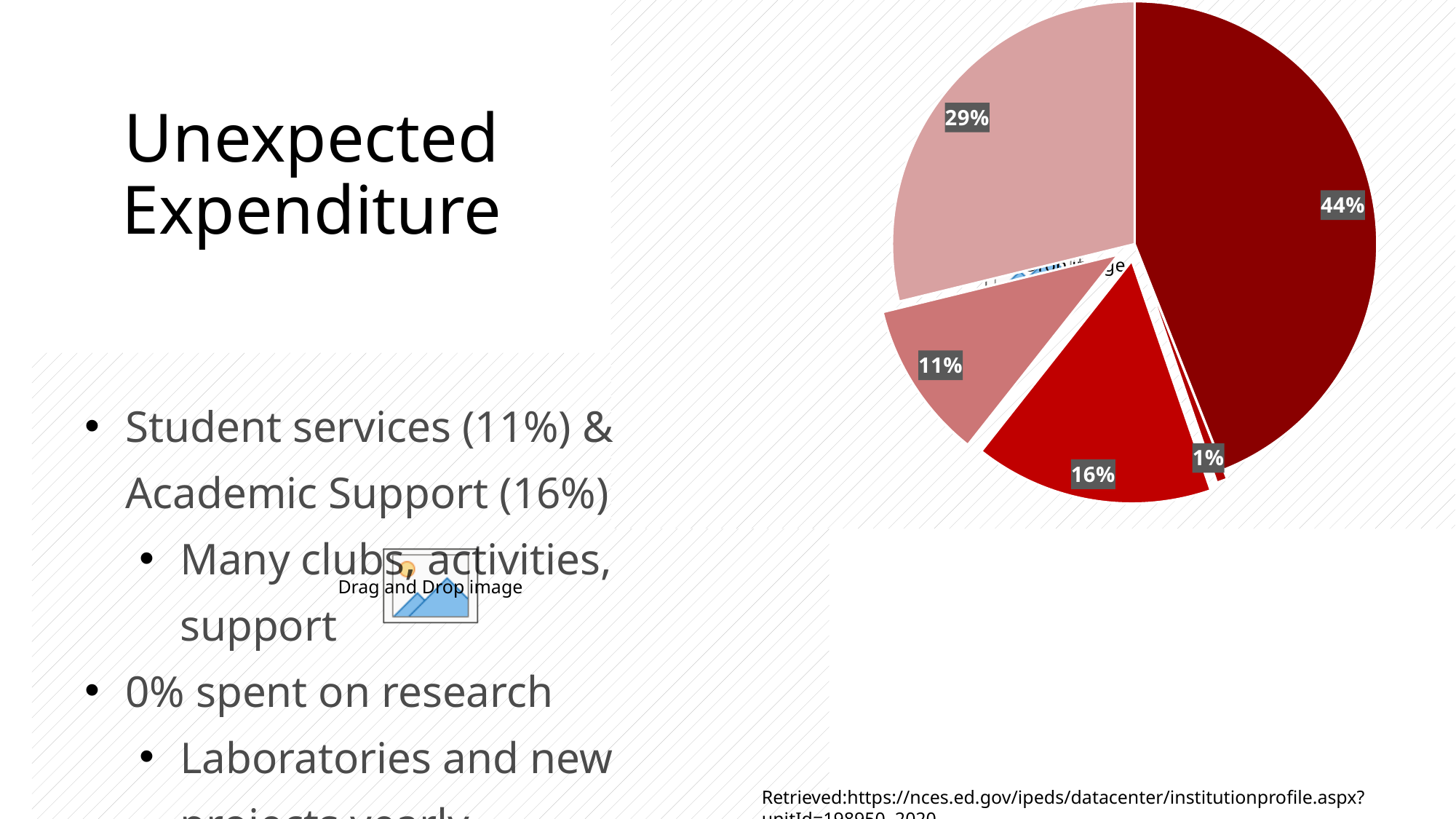
Which is larger, the 29% slice or the 16% slice? the 29% slice Which is larger, the 11% slice or the 16% slice? the 16% slice What colour is the largest slice of the pie chart? dark red What is the difference in percentage points between the 44% slice and the 29% slice? 15 percentage points What is the percentage shown on the light pink slice at the top left of the pie chart? 29% What is the difference in percentage points between the 16% slice and the 11% slice? 5 percentage points What kind of chart is shown on the slide? pie chart Is the largest slice of the pie chart greater or less than 50%? less What is the percentage shown on the bright red slice at the bottom of the pie chart? 16% What is the percentage shown on the largest slice of the pie chart? 44% What is the percentage shown on the smallest labelled slice of the pie chart? 1%